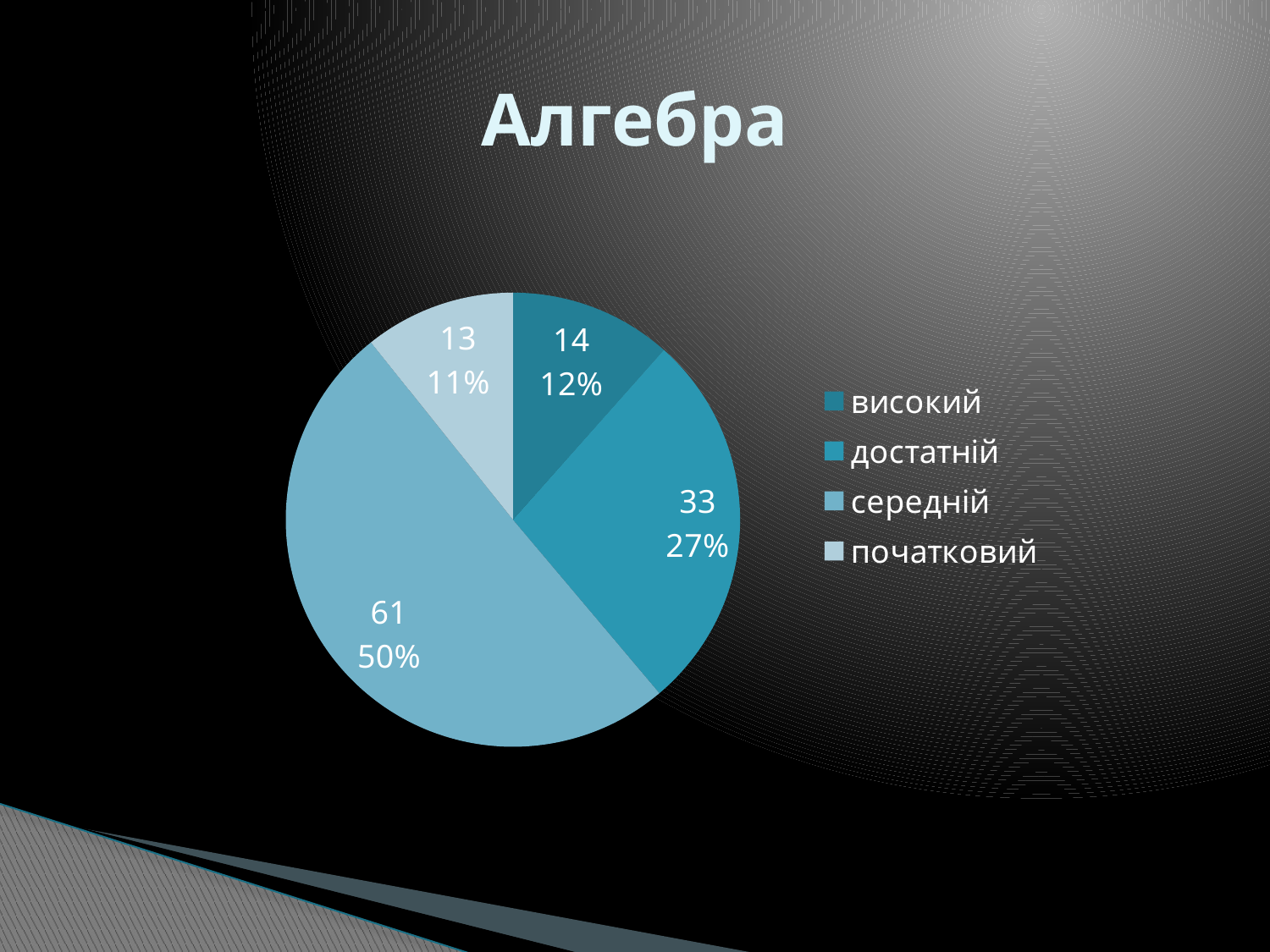
What kind of chart is shown on the slide? pie chart Which category has the largest slice? середній Which category has the smallest slice? початковий How many entries does the legend list? 4 What percentage share does початковий have? 11% What is the value for середній? 61 What is the title of the chart? Алгебра What is the value for високий? 14 What is the difference between the values for середній and достатній? 28 What percentage share does середній have? 50% How many slices does the pie chart have? 4 What is the value for достатній? 33